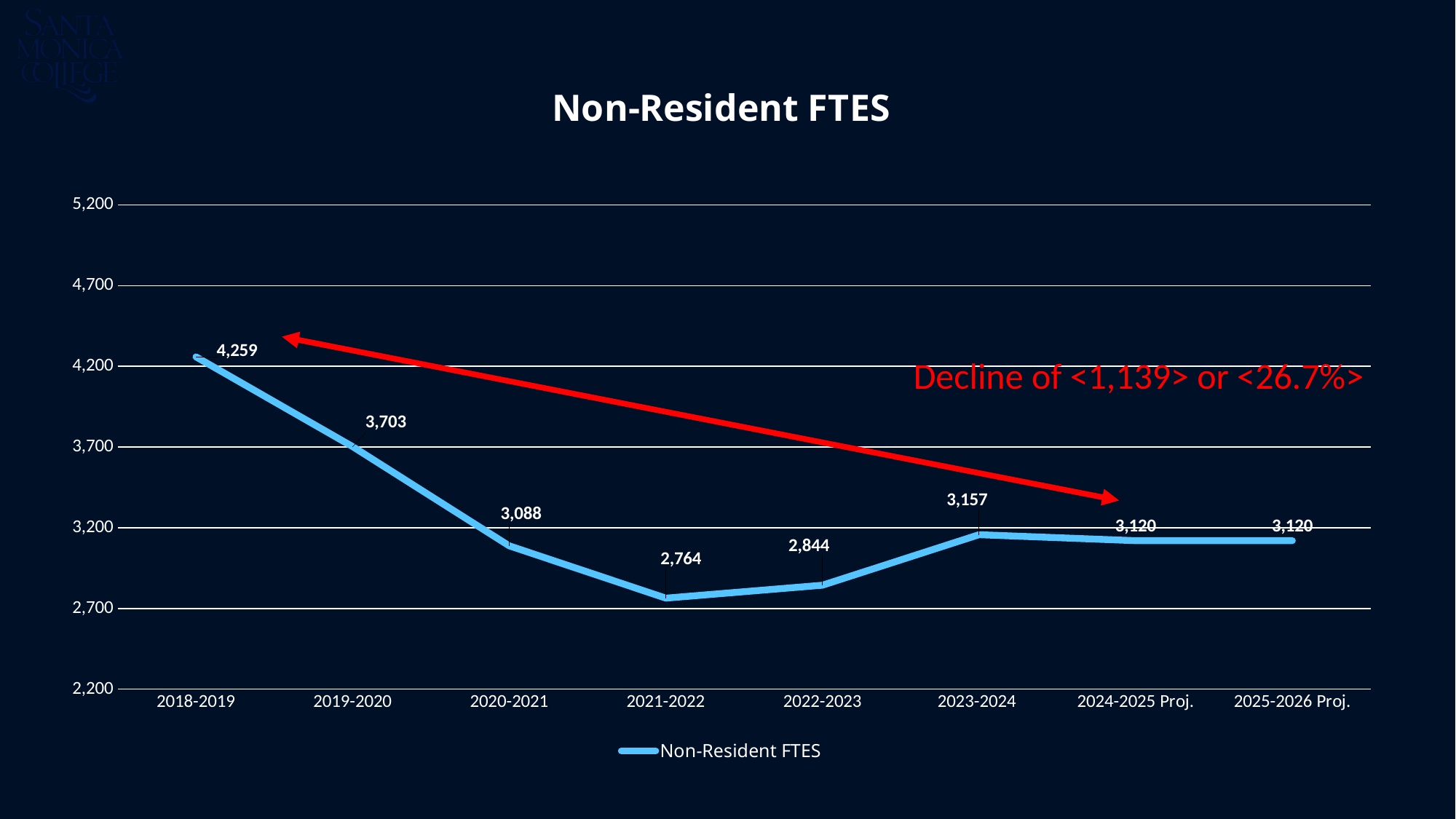
What is the projected Non-Resident FTES value for 2025-2026? 3,120 How many series does the legend list? 1 What is the difference between the Non-Resident FTES values for 2018-2019 and 2019-2020? 556 Which year has the highest Non-Resident FTES value? 2018-2019 What is the title of the chart? Non-Resident FTES What is the Non-Resident FTES value for 2018-2019? 4,259 What is the Non-Resident FTES value for 2021-2022? 2,764 How many years are shown on the x axis? 8 Which year has the lowest Non-Resident FTES value? 2021-2022 What is the Non-Resident FTES value for 2023-2024? 3,157 What kind of chart is shown on the slide? Line chart Which is larger, the Non-Resident FTES value for 2020-2021 or for 2022-2023? 2020-2021